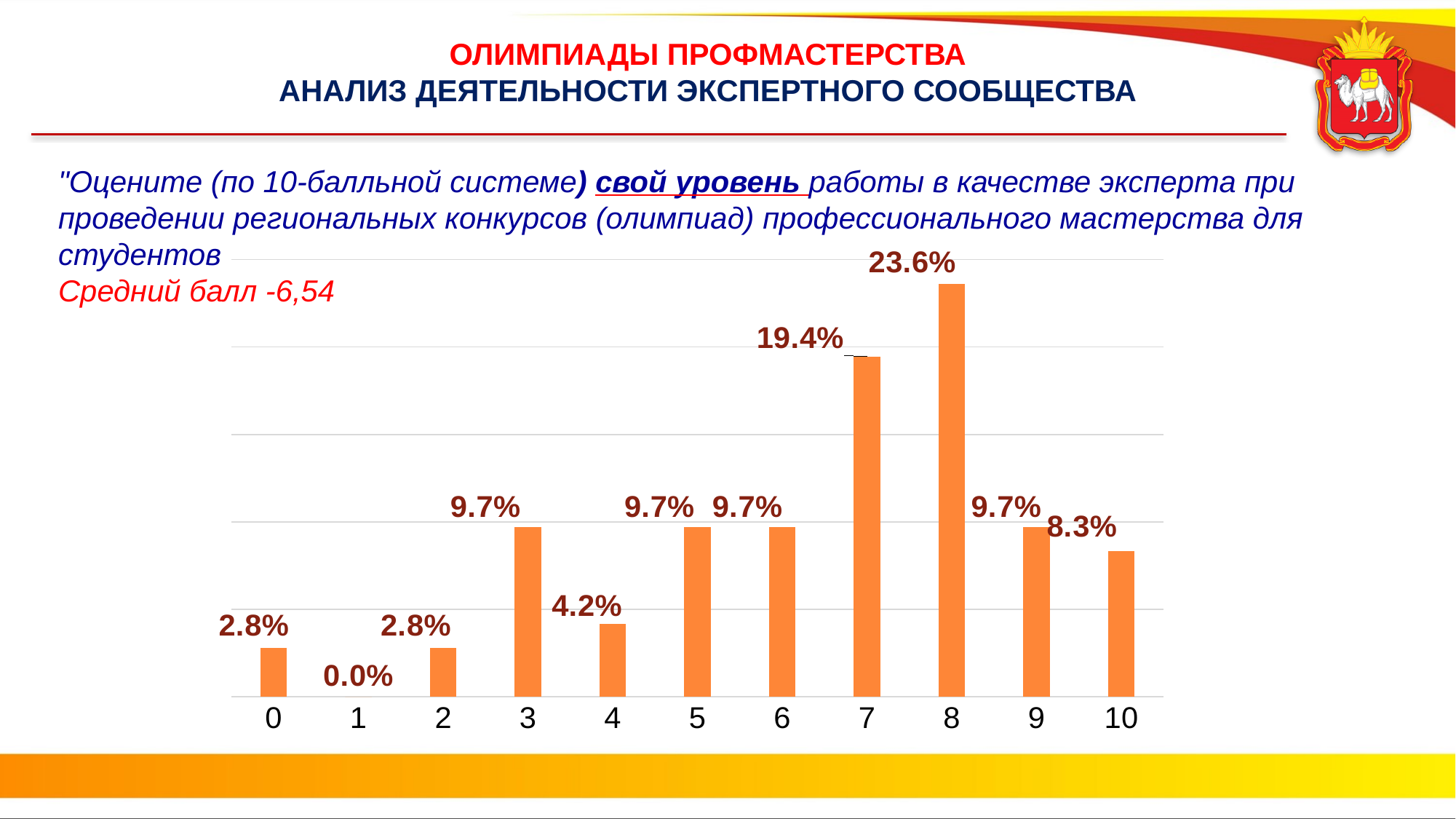
What is the average score stated on the slide? 6,54 Which is larger, the value for score 3 or the value for score 4? score 3 Which score has the highest percentage? 8 What is the value shown for score 10? 8.3% Which score has the lowest percentage? 1 How many score categories are shown on the x axis? 11 What is the difference between the values for score 8 and score 7? 4.2% What is the value shown for score 4? 4.2% What percentage of experts rated their level as 8? 23.6% What is the difference between the values for score 9 and score 10? 1.4% What is the value shown for score 7? 19.4% What kind of chart is shown on the slide? bar chart